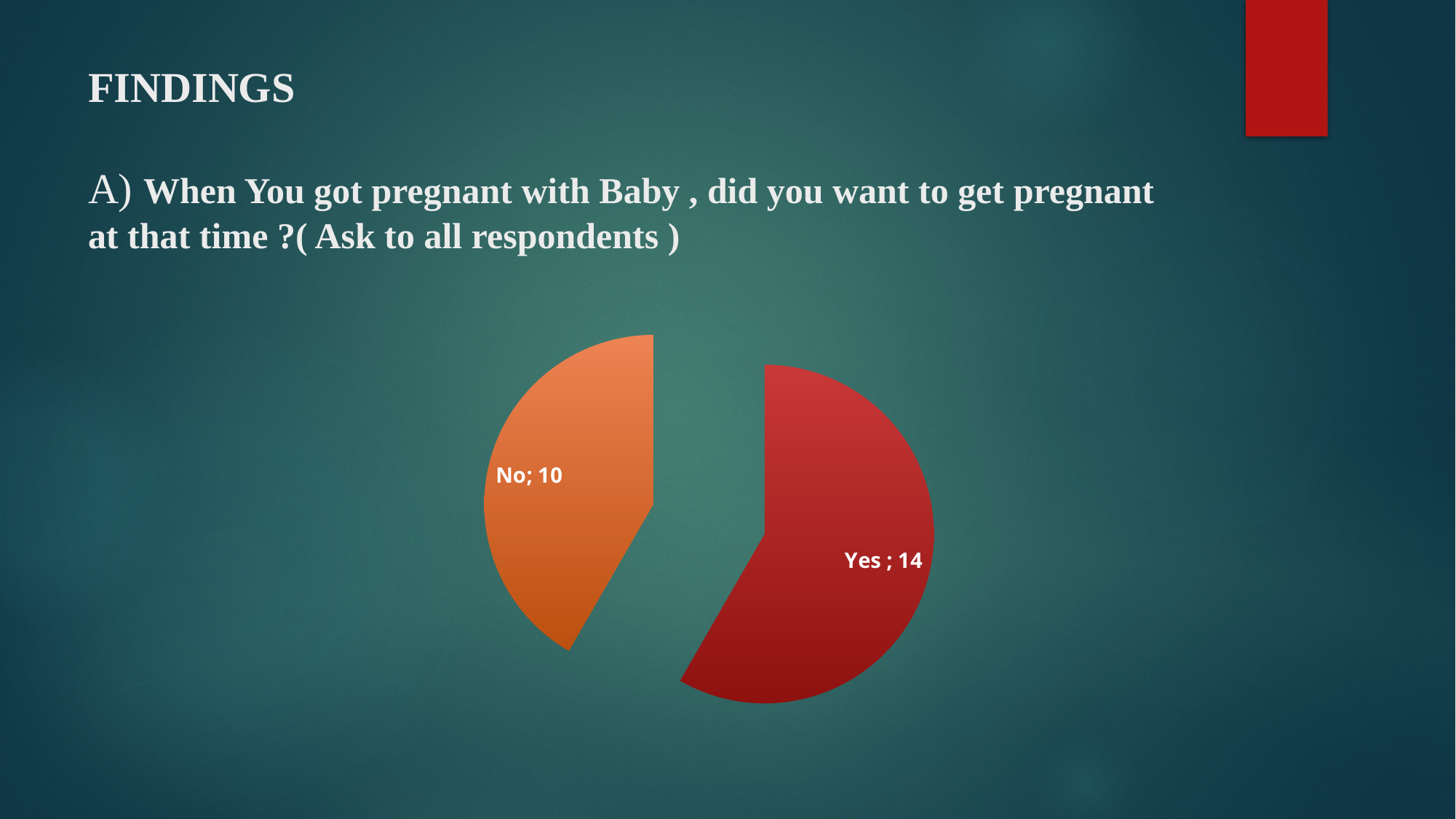
What kind of chart is shown on the slide? pie chart Which is larger, the "Yes" slice or the "No" slice? Yes How many slices does the pie chart have? 2 What colour is the "No" slice? orange What colour is the "Yes" slice? red What share of the pie does the "No" slice represent, as a fraction? 10/24 Which slice is the largest? Yes What is the value for the "No" slice? 10 What is the total of all slices in the pie chart? 24 Which slice is the smallest? No What is the difference between the "Yes" and "No" values? 4 What is the value for the "Yes" slice? 14